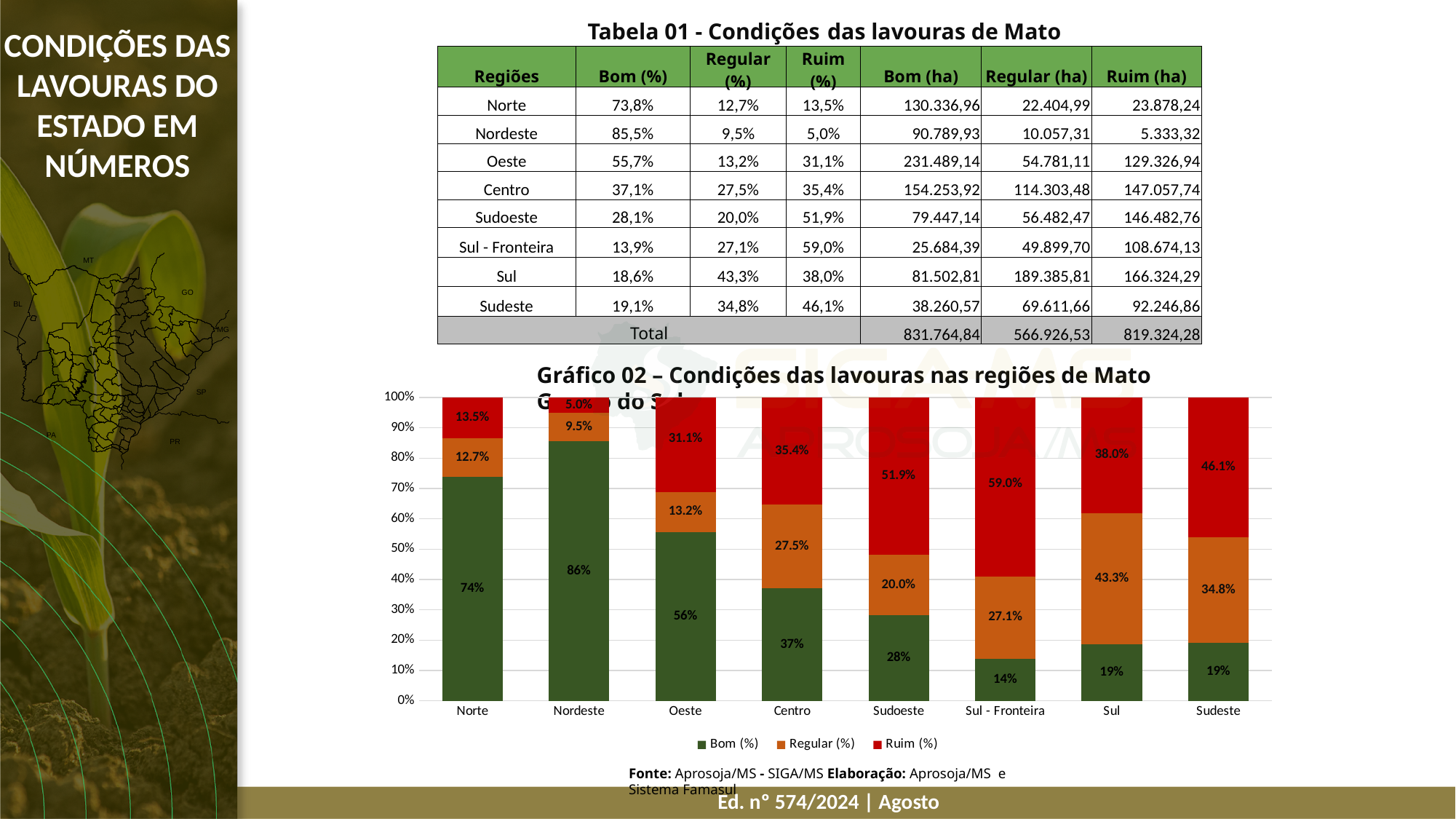
In Gráfico 02, which is larger: the Regular (%) value for Centro or for Sudoeste? Centro How many regions are shown on the x axis of Gráfico 02? 8 In Gráfico 02, which region has the lowest Ruim (%) value? Nordeste How many series does the legend of Gráfico 02 list? 3 In Gráfico 02, which region has the highest Bom (%) value? Nordeste Which colour represents the Ruim (%) series in Gráfico 02? red In Gráfico 02, what is the Bom (%) value for Nordeste? 86% In Gráfico 02, what is the difference between the Ruim (%) values for Sudeste and Sul? 8.1% In Gráfico 02, what is the Regular (%) value for Sul? 43.3% What kind of chart is Gráfico 02? stacked bar chart In Gráfico 02, what is the Ruim (%) value for Sul - Fronteira? 59.0% In Gráfico 02, which region has the highest Ruim (%) value? Sul - Fronteira